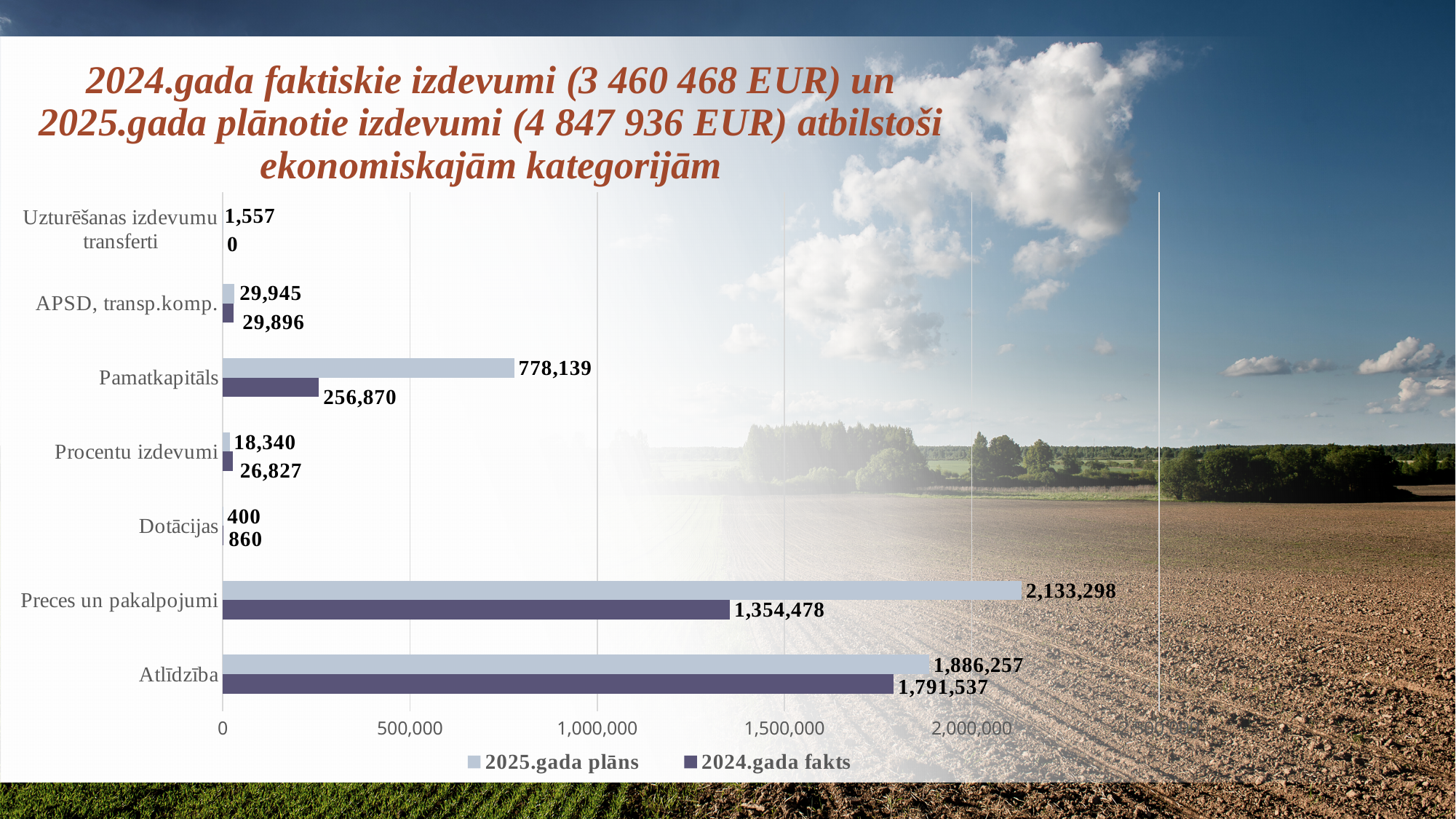
Which category has the highest 2025.gada plāns value? Preces un pakalpojumi What kind of chart is shown on the slide? Bar chart For Procentu izdevumi, which is larger: the 2025.gada plāns value or the 2024.gada fakts value? 2024.gada fakts How many series does the legend list? 2 How many categories are shown on the chart? 7 Which category has the highest 2024.gada fakts value? Atlīdzība What is the 2025.gada plāns value for Pamatkapitāls? 778,139 Which category has the lowest 2025.gada plāns value? Dotācijas What is the difference between the 2025.gada plāns and 2024.gada fakts values for Atlīdzība? 94,720 What is the difference between the 2025.gada plāns and 2024.gada fakts values for Pamatkapitāls? 521,269 What is the 2024.gada fakts value for Preces un pakalpojumi? 1,354,478 What is the 2024.gada fakts value for Uzturēšanas izdevumu transferti? 0